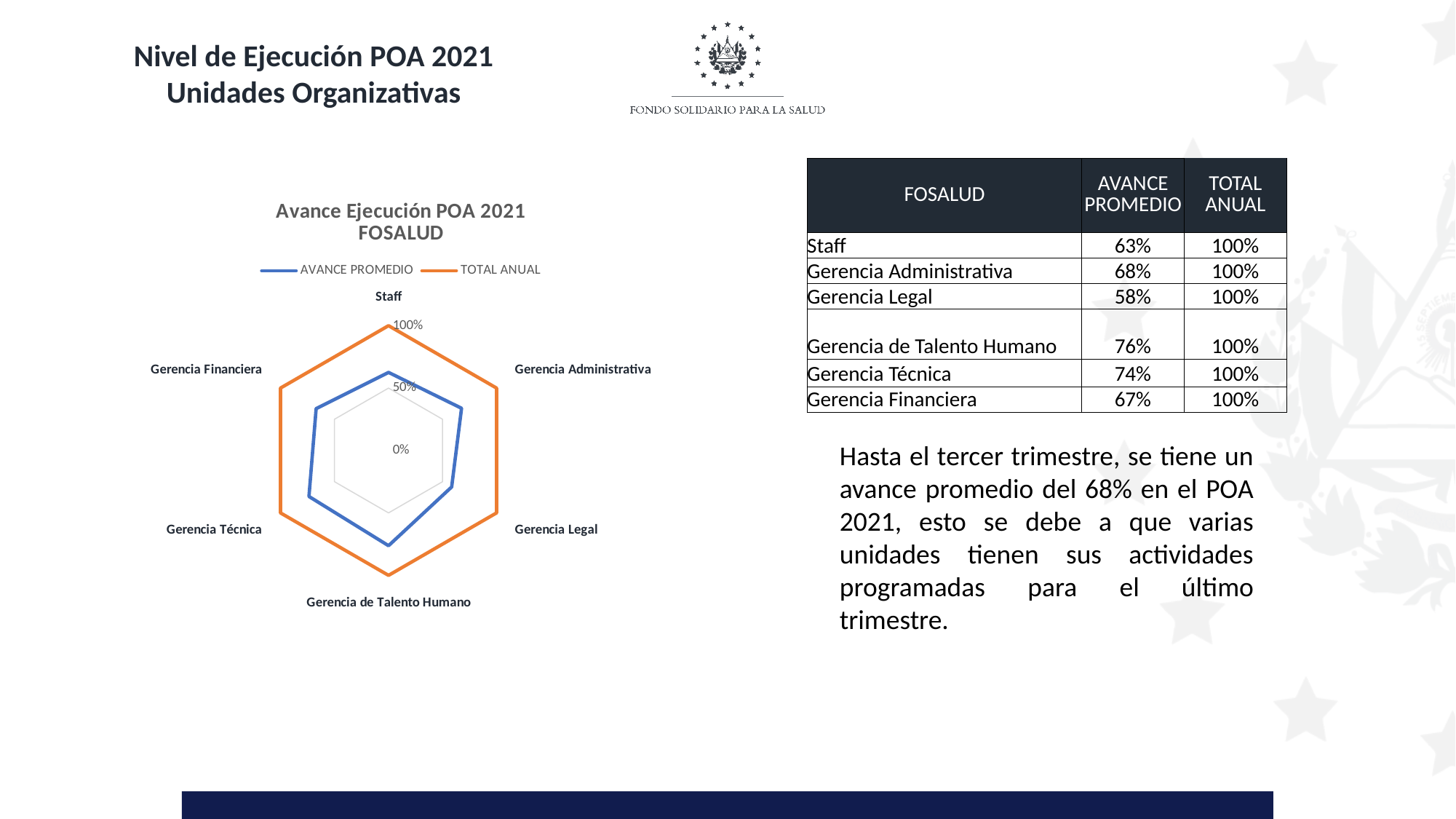
What kind of chart is shown on the slide? Radar chart Which organizational unit has the lowest AVANCE PROMEDIO? Gerencia Legal Which colour represents the TOTAL ANUAL series on the radar chart? Orange What is the title of the radar chart? Avance Ejecución POA 2021 FOSALUD What is the TOTAL ANUAL value for Staff? 100% Is the AVANCE PROMEDIO value for Staff on the radar chart greater or less than 50%? greater How many series does the legend of the radar chart list? 2 Which organizational unit has the highest AVANCE PROMEDIO? Gerencia de Talento Humano What is the AVANCE PROMEDIO value for Gerencia de Talento Humano? 76% How many categories (organizational units) are plotted on the radar chart? 6 What is the difference in AVANCE PROMEDIO between Gerencia de Talento Humano and Gerencia Legal? 18 percentage points What is the AVANCE PROMEDIO value for Gerencia Legal? 58%